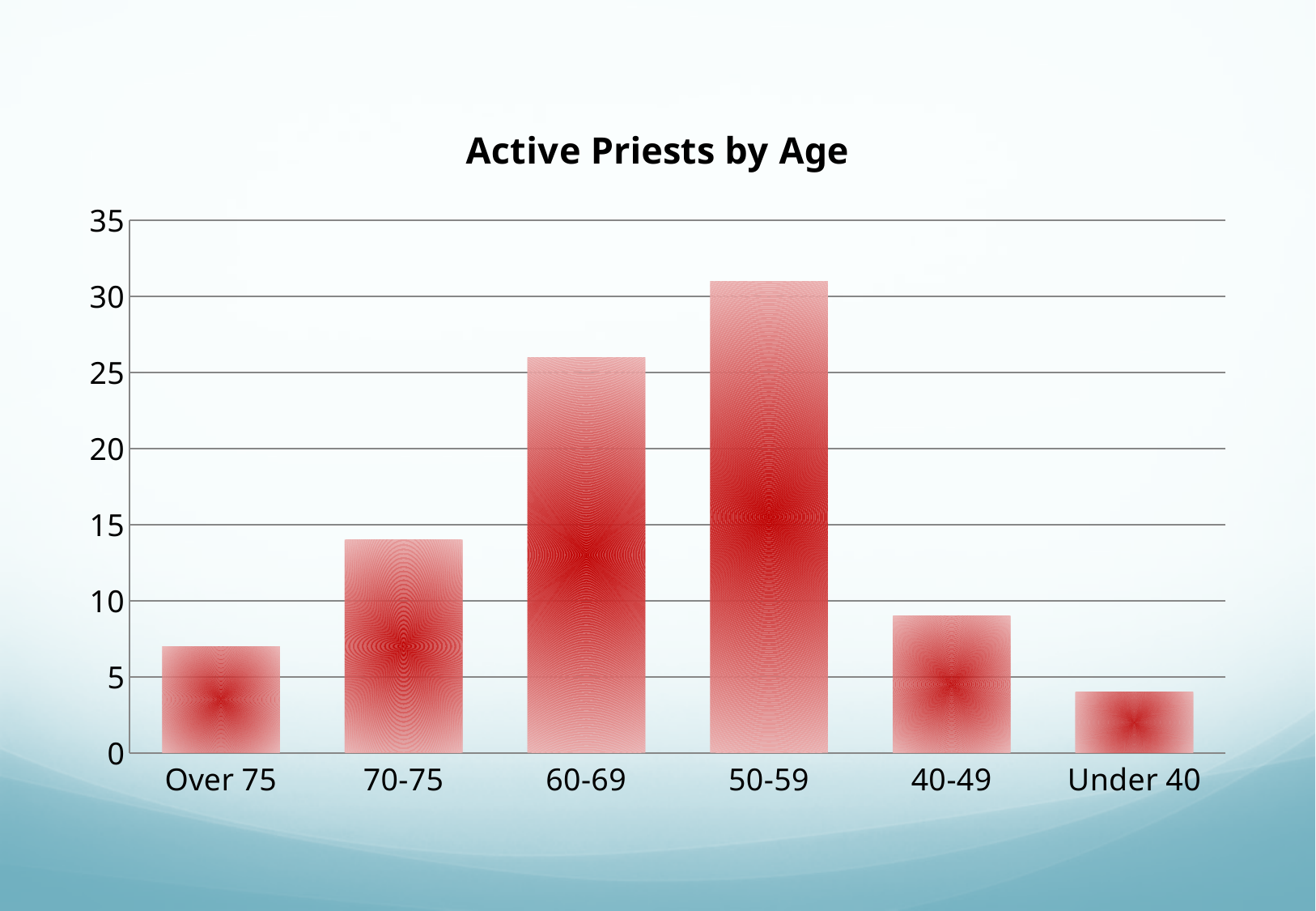
Which age category has the lowest number of active priests? Under 40 Is the value for 70-75 greater or less than 15? less Which has more active priests, 40-49 or 70-75? 70-75 Is the value for 60-69 greater or less than 25? greater What type of chart is shown on the slide? bar chart Which age category has the highest number of active priests? 50-59 Is the value for Over 75 greater or less than 5? greater Which has more active priests, Over 75 or 40-49? 40-49 How many age categories are shown on the x axis? 6 What is the title of the chart? Active Priests by Age